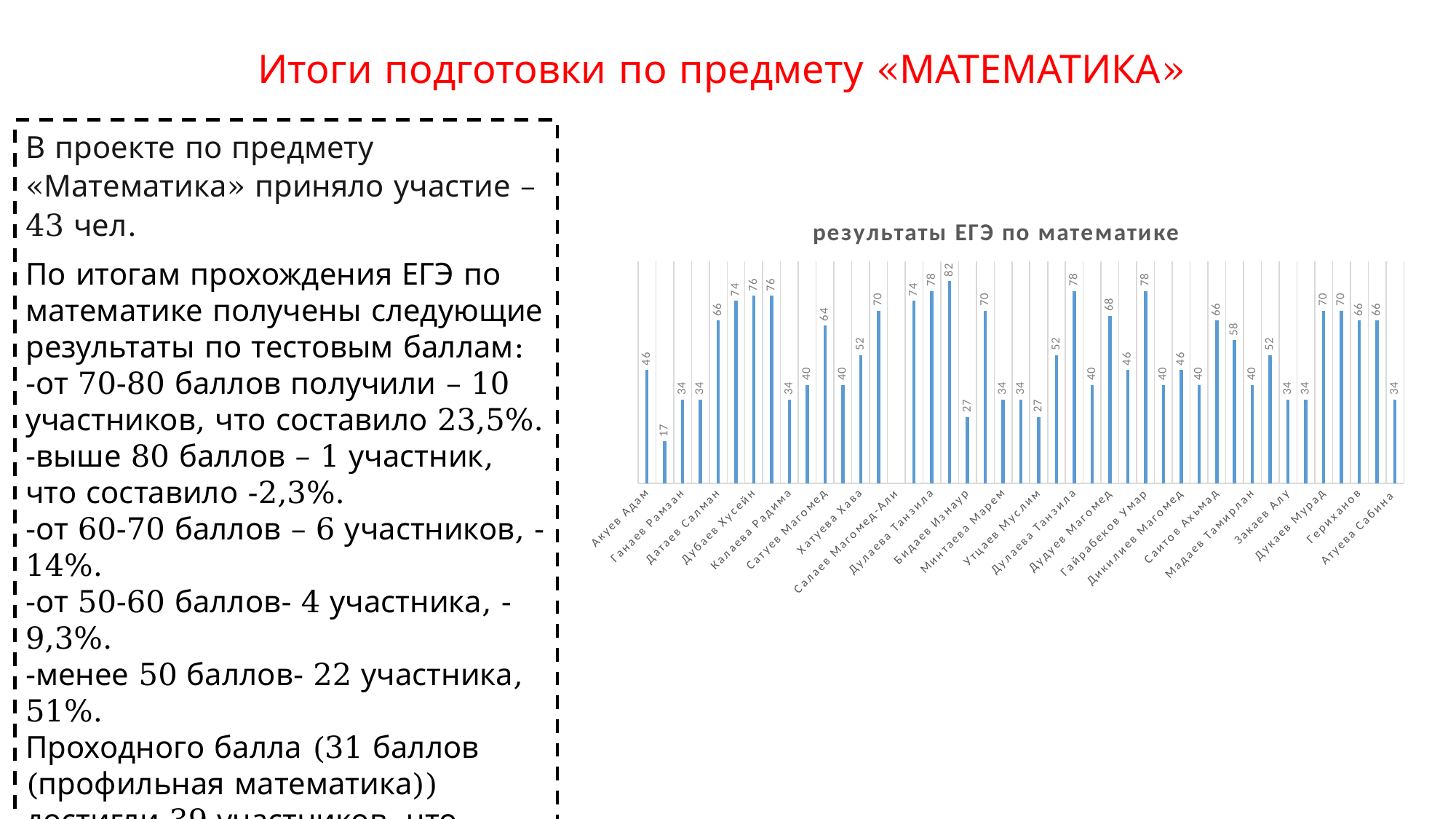
Is the highest value in the chart greater or less than 80? greater What colour are the bars in the chart? blue Is the lowest value in the chart greater or less than 20? less What kind of chart is shown on the slide? bar chart Is the value for Акуев Адам greater or less than the value for the second bar (17)? greater What is the value for Акуев Адам? 46 What is the title of the chart? результаты ЕГЭ по математике What is the highest value shown in the chart? 82 What is the lowest value shown in the chart? 17 How many bars in the chart have a value above 80? 1 What is the difference between the highest and lowest values in the chart? 65